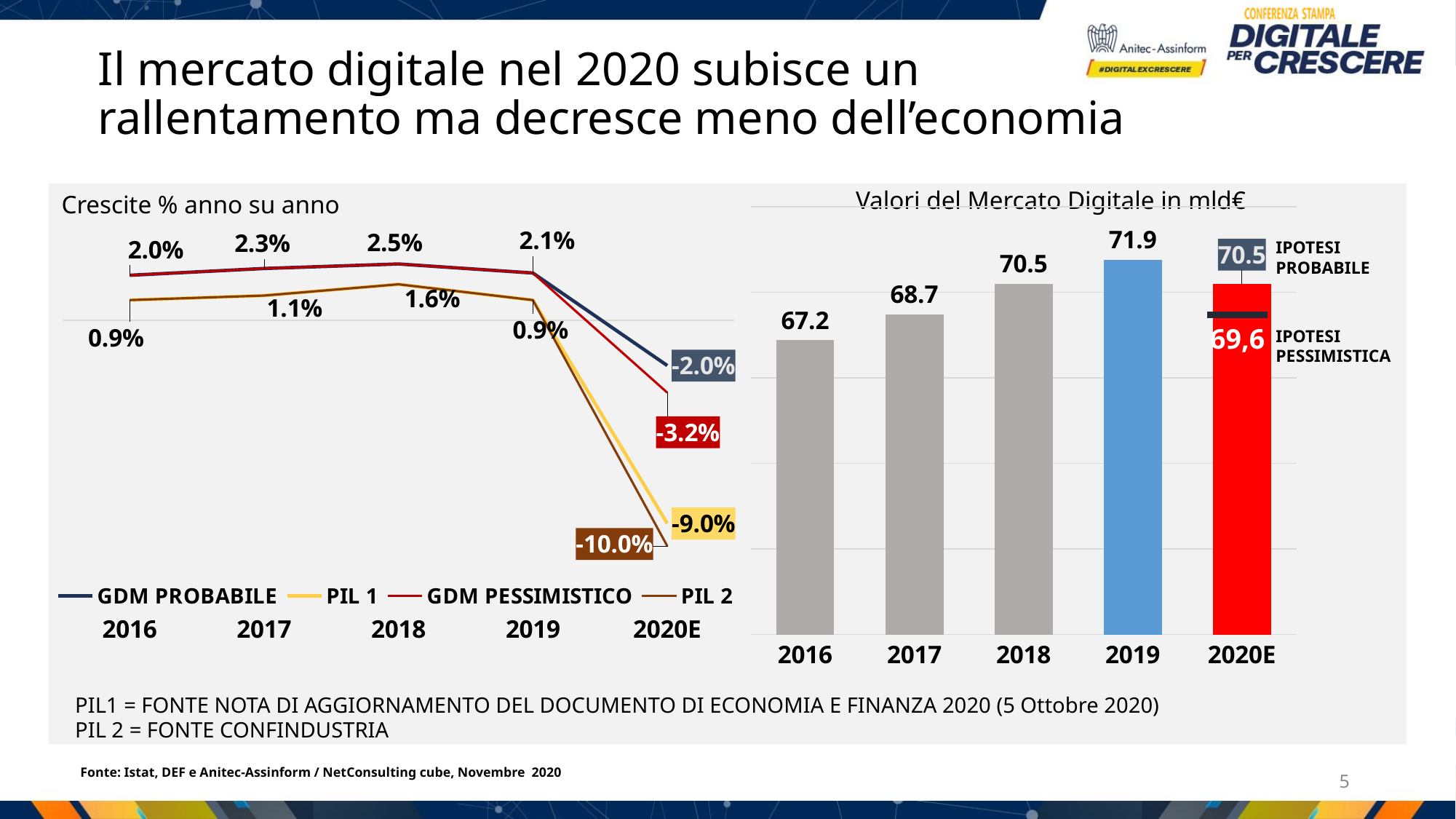
In the 'Valori del Mercato Digitale in mld€' chart, which year has the lowest value? 2016 In the 'Crescite % anno su anno' chart, what is the 2020E value for PIL 2? -10.0% In the 'Crescite % anno su anno' chart, what is the difference between the 2020E values of PIL 1 and PIL 2? 1.0% In the 'Crescite % anno su anno' chart, how many series does the legend list? 4 In the 'Valori del Mercato Digitale in mld€' chart, what is the value for 2016? 67.2 In the 'Valori del Mercato Digitale in mld€' chart, what is the value for 2019? 71.9 In the 'Crescite % anno su anno' chart, which is larger at 2020E: GDM PROBABILE or PIL 1? GDM PROBABILE In the 'Valori del Mercato Digitale in mld€' chart, what kind of chart is used? bar chart In the 'Valori del Mercato Digitale in mld€' chart, which year has the highest value? 2019 In the 'Crescite % anno su anno' chart, what is the 2020E value for GDM PESSIMISTICO? -3.2% In the 'Valori del Mercato Digitale in mld€' chart, what is the difference between the 2019 value and the 2018 value? 1.4 In the 'Valori del Mercato Digitale in mld€' chart, what is the 2020E value under the 'IPOTESI PESSIMISTICA'? 69,6